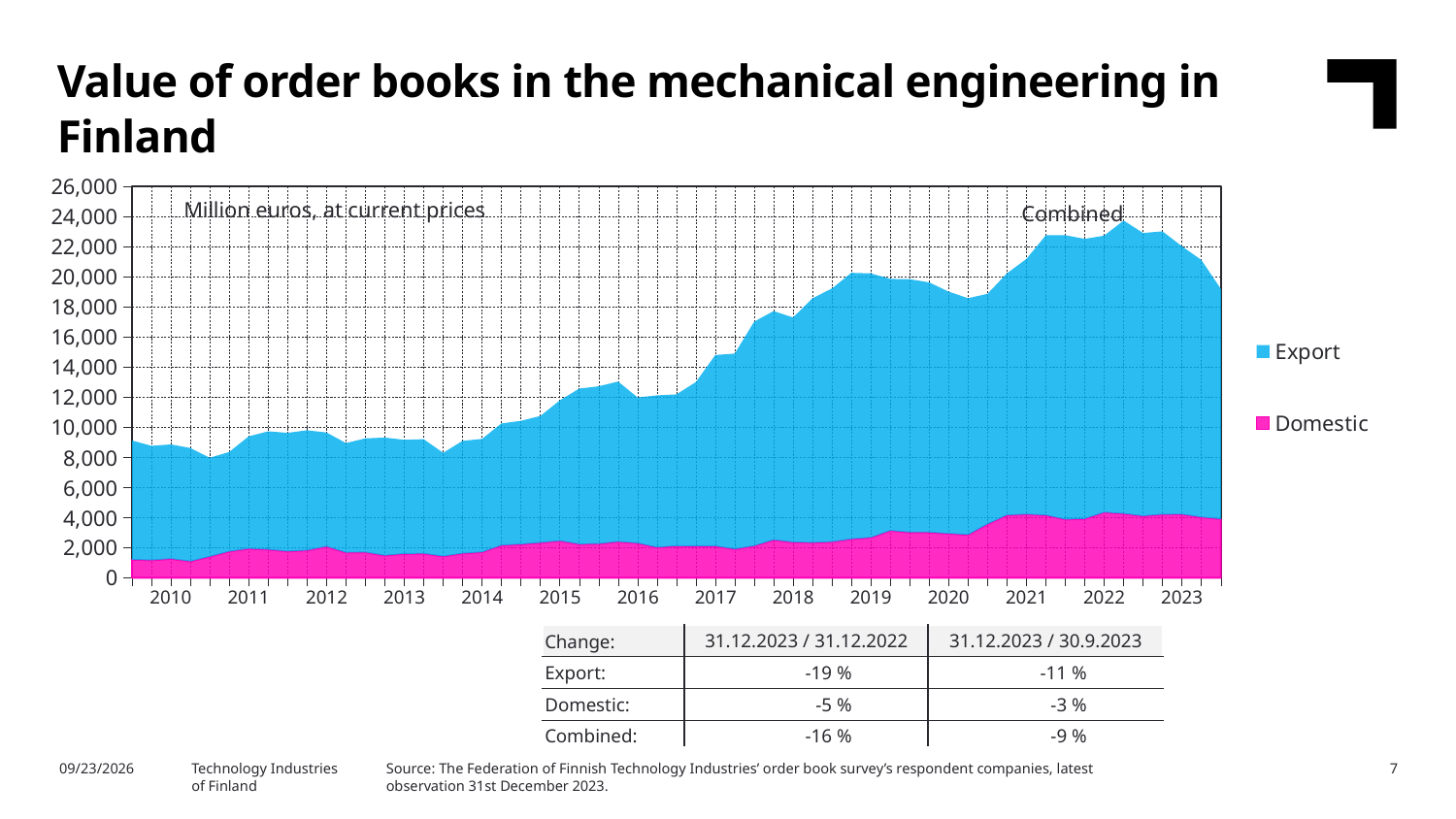
Is the combined value at the end of 2023 greater or less than 22,000? less Is the combined value at the start of 2010 greater or less than 8,000? greater Which two series are listed in the chart legend? Export and Domestic Is the Domestic value at the start of 2010 greater or less than 2,000? less How many series does the chart legend list? 2 What kind of chart is shown on the slide? Area chart Does the combined value of order books generally rise or fall from 2010 to 2022? rise Which series is larger throughout the chart, Export or Domestic? Export How many years are labelled on the x axis of the chart? 14 What unit is the chart measured in, according to the label inside the plot area? Million euros, at current prices In which year does the combined value of order books reach its highest point? 2022